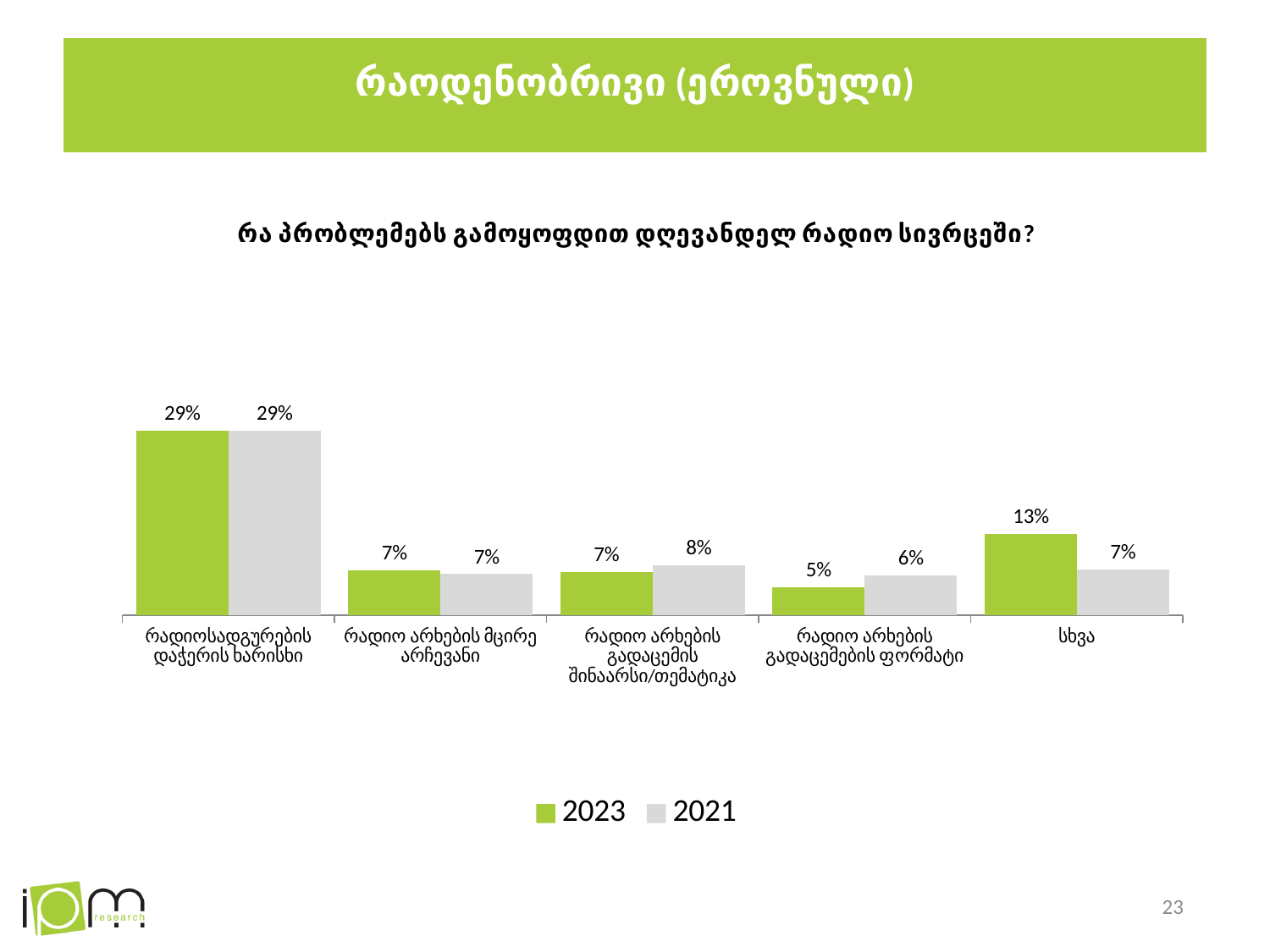
What is the 2021 value for "რადიო არხების გადაცემების ფორმატი"? 6% What is the 2023 value for "რადიოსადგურების დაჭერის ხარისხი"? 29% Which category has the highest 2023 value? რადიოსადგურების დაჭერის ხარისხი What is the 2021 value for "რადიო არხების გადაცემის შინაარსი/თემატიკა"? 8% Which series is shown in green in the legend? 2023 What is the 2023 value for "სხვა"? 13% Which category has the lowest 2023 value? რადიო არხების გადაცემების ფორმატი What kind of chart is shown on the slide? Bar chart What is the difference between the 2023 and 2021 values for "სხვა"? 6% For "სხვა", which year has the larger value, 2023 or 2021? 2023 How many series does the legend list? 2 How many categories are shown on the x axis? 5